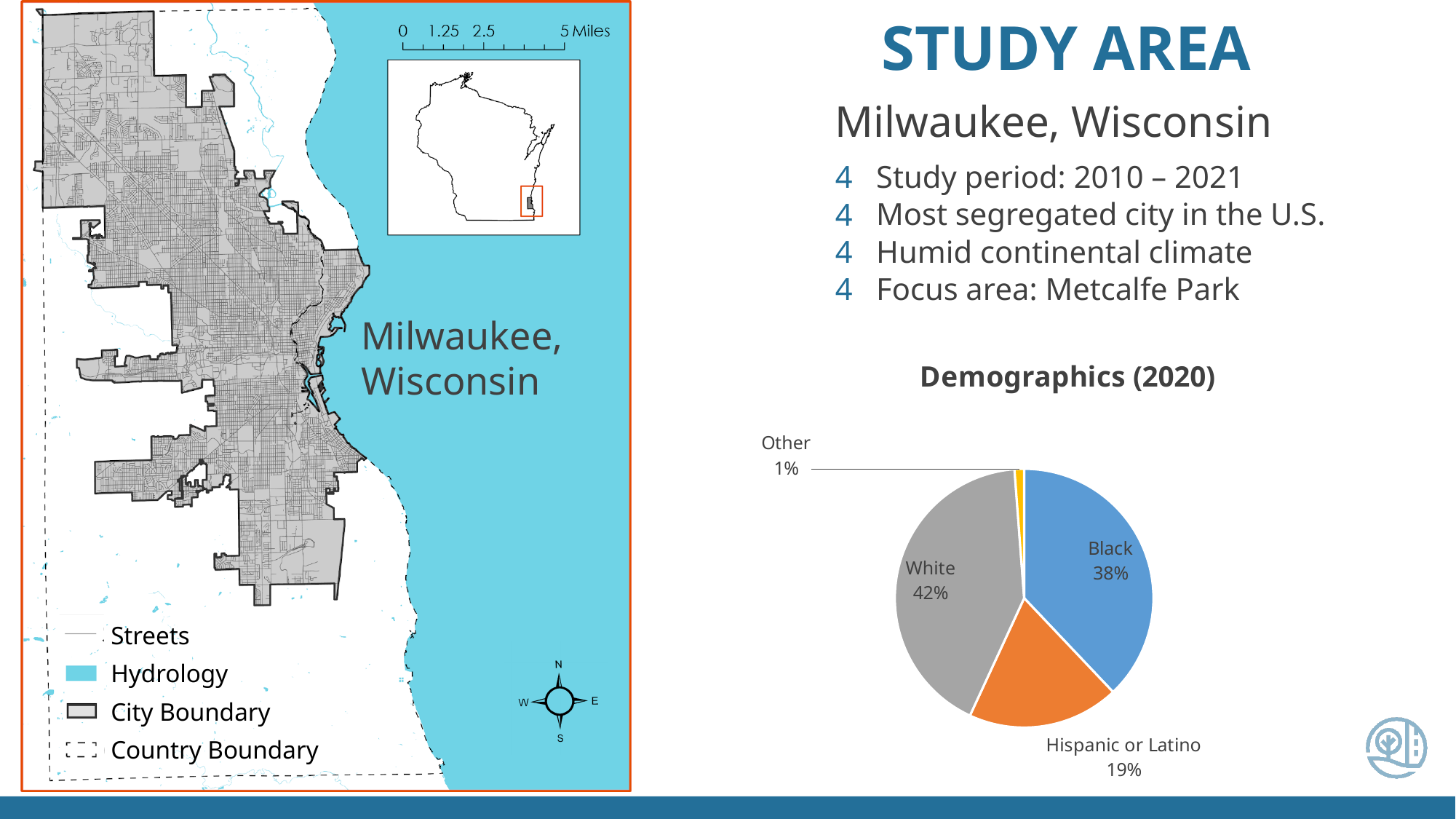
What type of chart is used to show the Demographics (2020) data? pie chart What is the title of the pie chart on the slide? Demographics (2020) How many slices does the Demographics (2020) pie chart have? 4 What share of the Demographics (2020) pie is labelled Other? 1% In the Demographics (2020) pie chart, what is the difference in percentage points between the Black and Hispanic or Latino slices? 19 In the Demographics (2020) pie chart, which is larger: the Black slice or the Hispanic or Latino slice? Black In the Demographics (2020) pie chart, what is the difference in percentage points between the White and Black slices? 4 What share of the Demographics (2020) pie is labelled Hispanic or Latino? 19% Which slice of the Demographics (2020) pie chart is the smallest? Other Which slice of the Demographics (2020) pie chart is the largest? White What share of the Demographics (2020) pie is labelled White? 42% What share of the Demographics (2020) pie is labelled Black? 38%